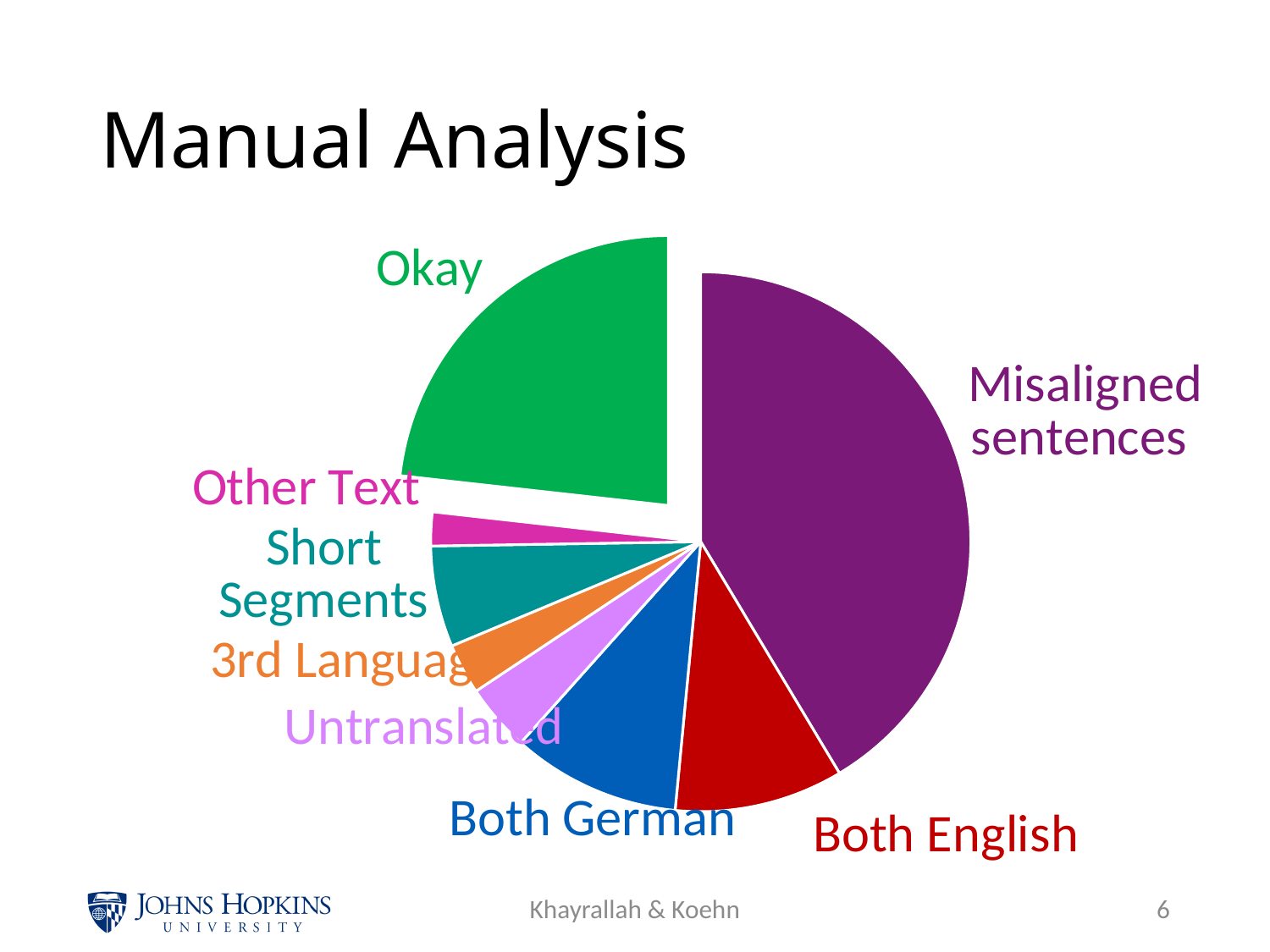
Which slice is larger, Both English or 3rd Language? Both English Which slice of the pie chart is pulled out (exploded) from the rest of the pie? Okay Which category has the largest slice of the pie chart? Misaligned sentences Which slice is larger, Both German or Untranslated? Both German Which slice is larger, Okay or Both English? Okay What kind of chart is shown on the slide? pie chart Which category has the smallest slice of the pie chart? Other Text How many slices does the pie chart have? 8 What is the title of the slide containing the pie chart? Manual Analysis